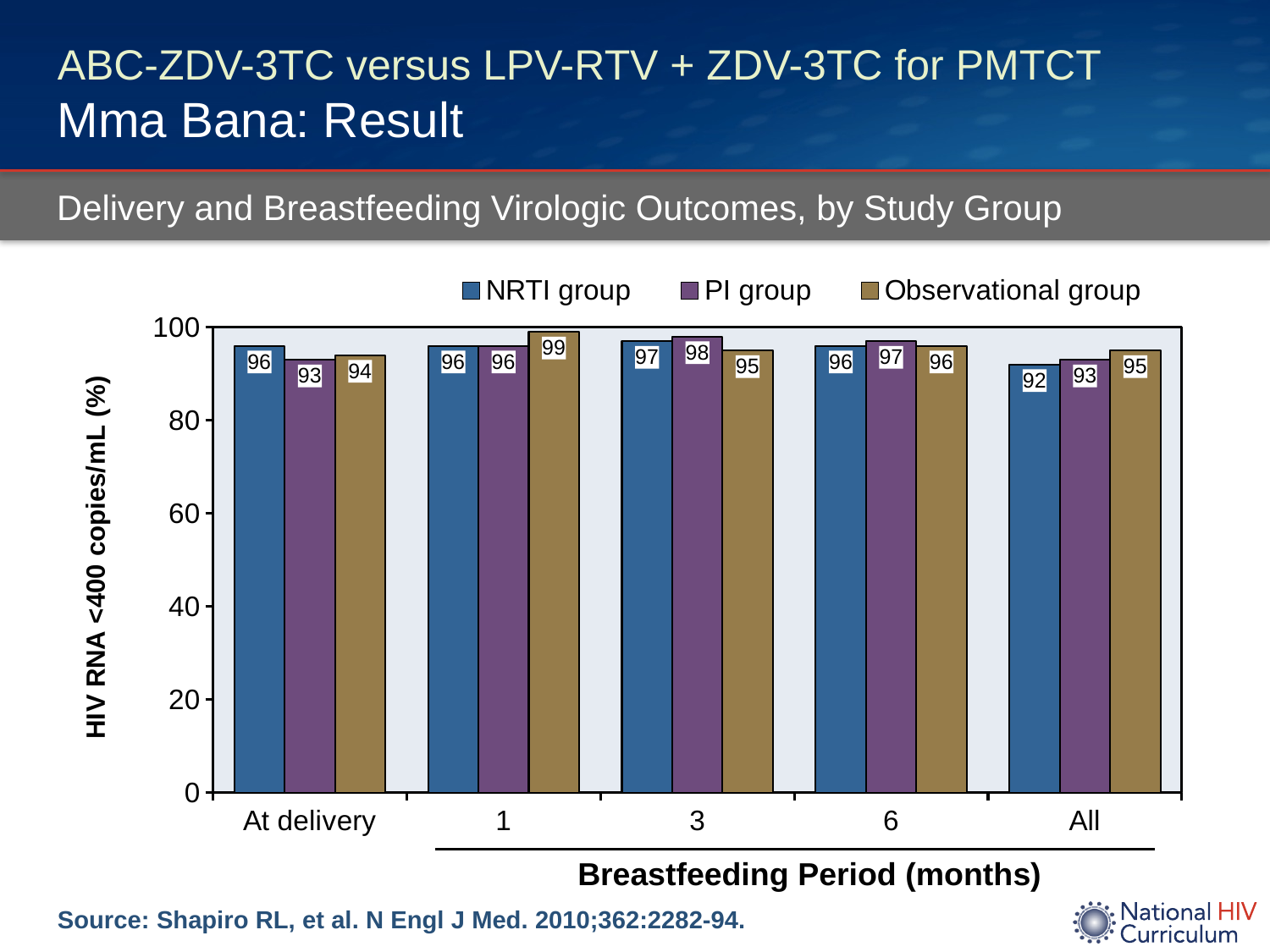
How many categories are shown on the x axis? 5 What is the value for the PI group at 3 months of breastfeeding? 98 What is the difference between the Observational group and the NRTI group in the 'All' category? 3 What is the value for the NRTI group at delivery? 96 What is the value for the NRTI group in the 'All' category? 92 What kind of chart is shown on the slide? Bar chart What is the label of the y axis? HIV RNA <400 copies/mL (%) What is the value for the Observational group at 1 month of breastfeeding? 99 How many series does the legend list? 3 Which group has the lowest value in the 'All' category? NRTI group Which group has the highest value at 1 month of breastfeeding? Observational group Which is larger at delivery: the NRTI group or the PI group? NRTI group